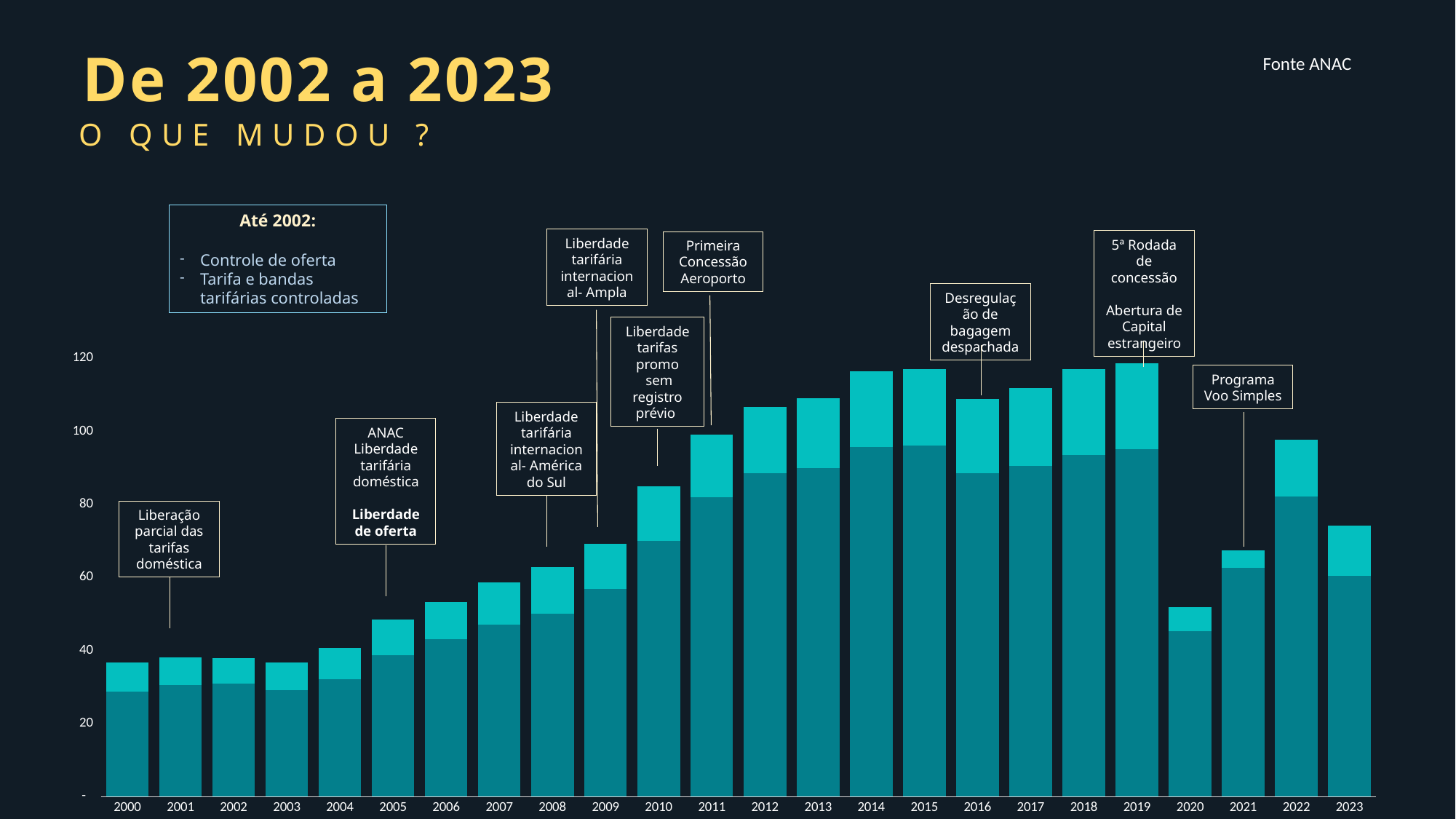
Among the years 2010 to 2023, which year has the lowest bar? 2020 Is the total bar height for 2012 greater or less than 100? greater What kind of chart is shown on the slide? bar chart Which bar is taller, 2020 or 2021? 2021 What source is cited in the top right corner of the slide? Fonte ANAC How many years are shown along the x axis of the chart? 24 Which year is the first category on the x axis? 2000 Do the bar totals generally rise or fall from 2000 to 2015? rise Is the total bar height for 2023 greater or less than 60? greater Is the total bar height for 2020 greater or less than 60? less Which year is the last category on the x axis? 2023